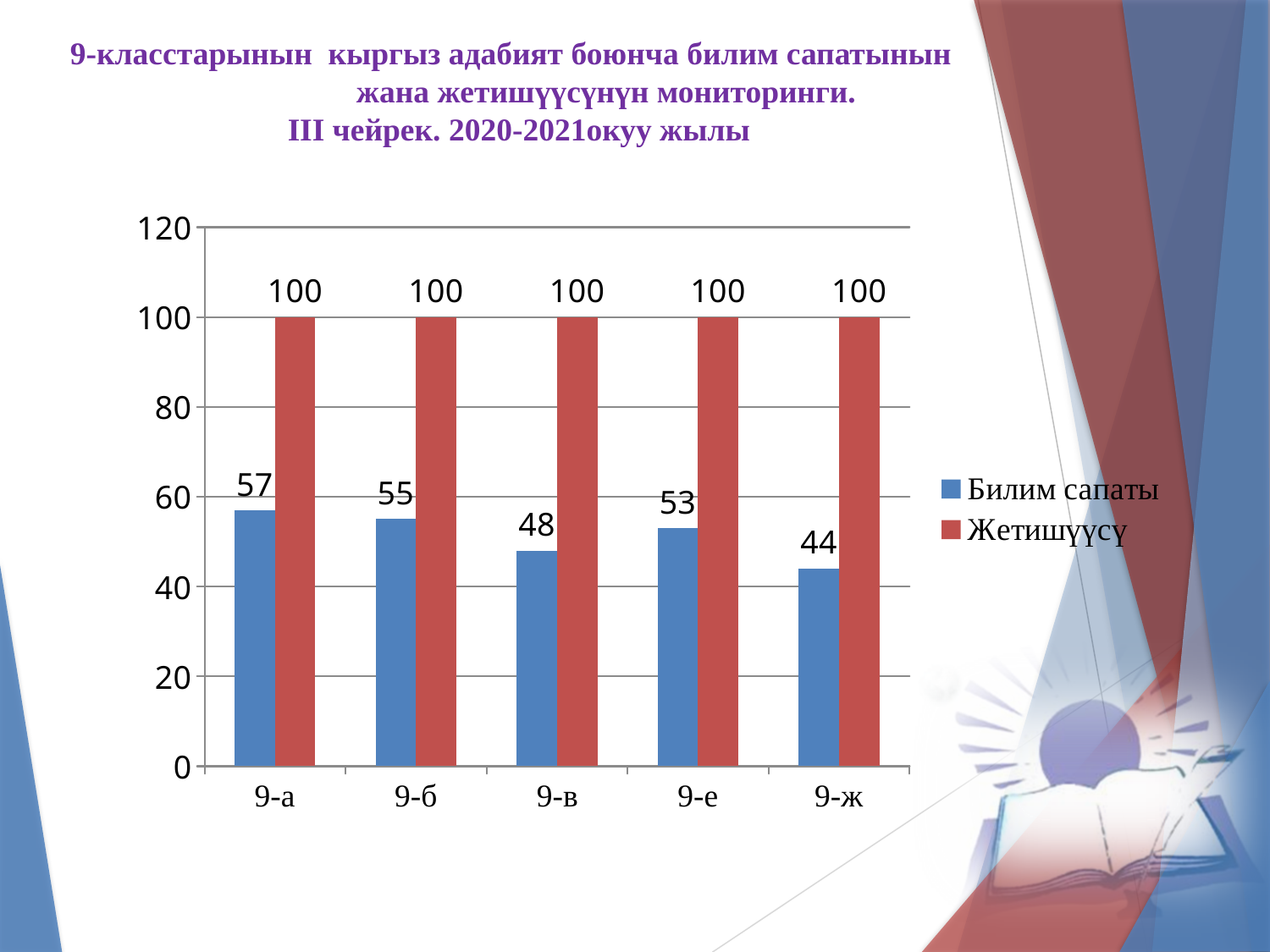
How many series does the legend list? 2 How many classes are shown on the x axis? 5 What is the value of Билим сапаты for 9-а? 57 What is the value of Билим сапаты for 9-ж? 44 Which is larger, the Билим сапаты value for 9-б or for 9-е? 9-б What is the value of Жетишүүсү for 9-в? 100 Which colour represents Жетишүүсү in the chart? red Which class has the lowest Билим сапаты value? 9-ж Which class has the highest Билим сапаты value? 9-а Is the Билим сапаты value for 9-в greater or less than 60? less What is the difference between the Билим сапаты values for 9-а and 9-ж? 13 What kind of chart is shown on the slide? bar chart